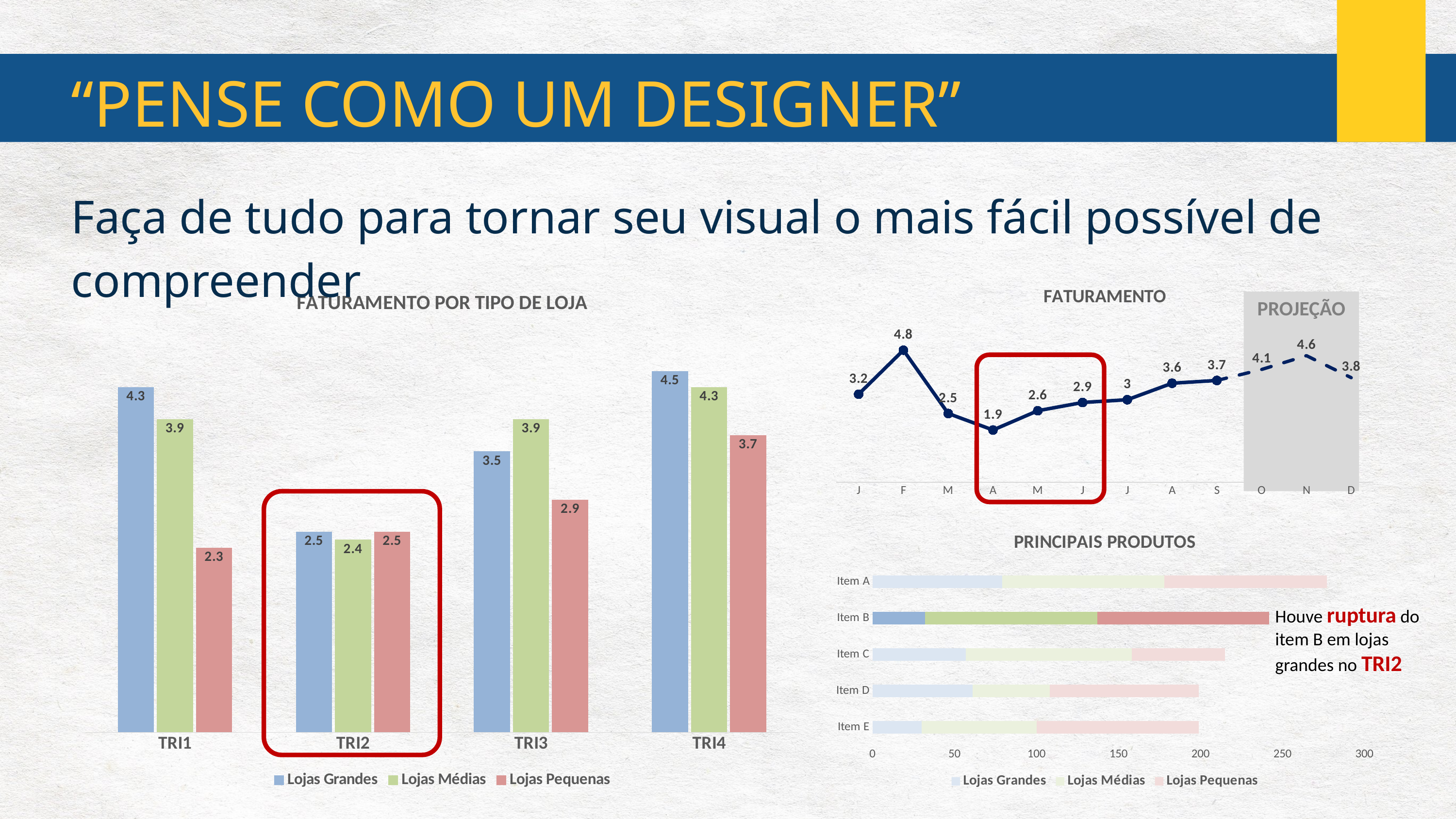
In the chart titled PRINCIPAIS PRODUTOS, how many items are listed on the vertical axis? 5 In the chart titled FATURAMENTO, how many data points are plotted? 12 In the chart titled FATURAMENTO POR TIPO DE LOJA, what is the value for Lojas Pequenas in TRI3? 2.9 In the chart titled PRINCIPAIS PRODUTOS, is the total for Item A greater or less than 250? greater In the chart titled FATURAMENTO POR TIPO DE LOJA, what is the value for Lojas Grandes in TRI1? 4.3 In the chart titled FATURAMENTO POR TIPO DE LOJA, how many series does the legend list? 3 In the chart titled FATURAMENTO POR TIPO DE LOJA, what is the difference between Lojas Grandes and Lojas Pequenas in TRI1? 2 In the chart titled FATURAMENTO POR TIPO DE LOJA, what kind of chart is it? bar chart In the chart titled FATURAMENTO, which month has the lowest value? A (1.9) In the chart titled FATURAMENTO POR TIPO DE LOJA, which quarter has the highest value for Lojas Grandes? TRI4 In the chart titled FATURAMENTO, is the value for N larger or smaller than the value for D? larger In the chart titled FATURAMENTO, what is the value for F? 4.8